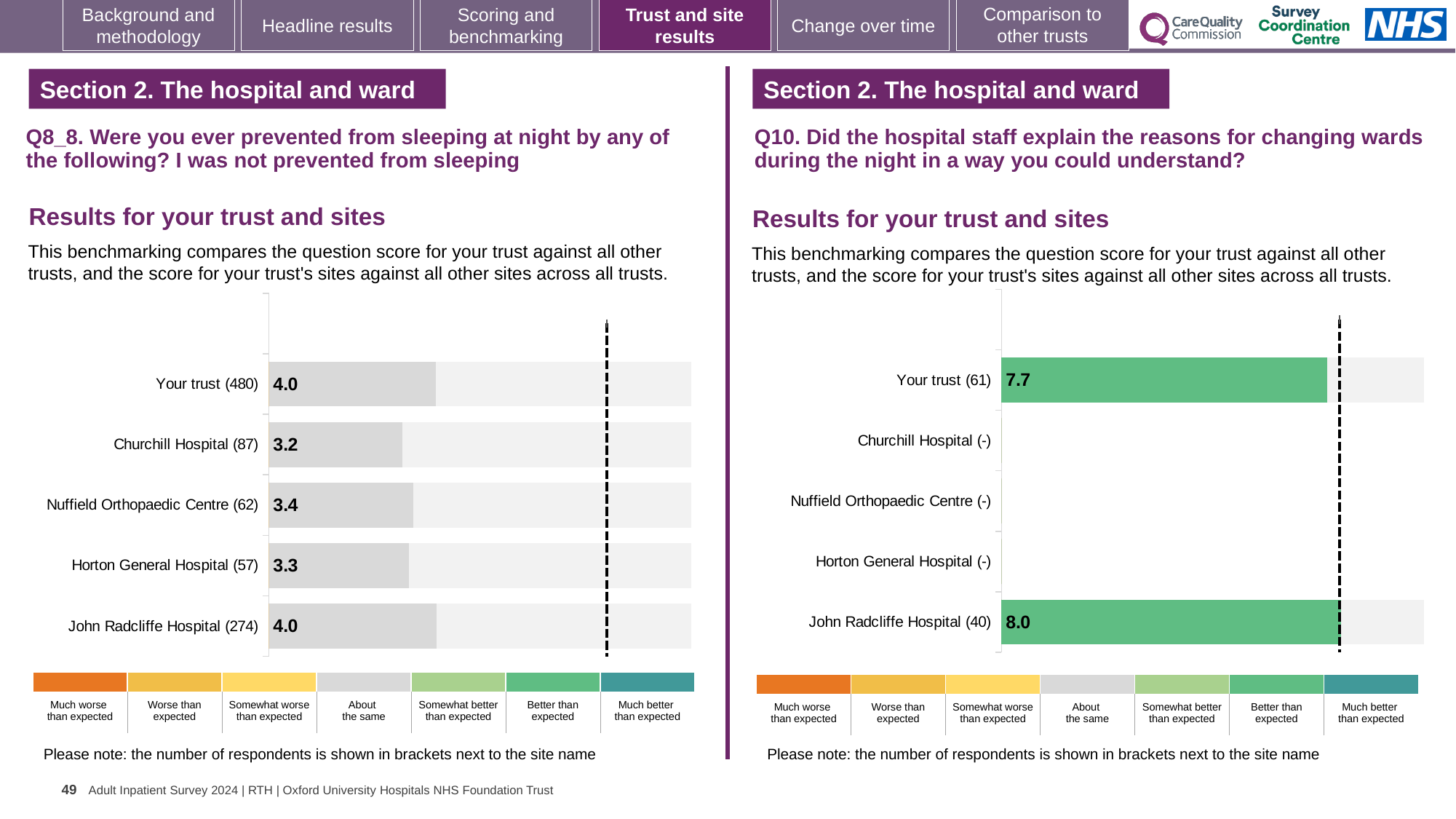
In the Q8_8 chart on the left, what is the score for Churchill Hospital? 3.2 In the Q8_8 chart on the left, what is the difference between the score for Your trust and the score for Churchill Hospital? 0.8 In the Q8_8 chart on the left, which site has the lowest score? Churchill Hospital In the Q10 chart on the right, what is the score for John Radcliffe Hospital? 8.0 In the Q10 chart on the right, how many sites have a score plotted (excluding Your trust)? 1 In the Q8_8 chart on the left, which has the higher score, Nuffield Orthopaedic Centre or Horton General Hospital? Nuffield Orthopaedic Centre In the Q8_8 chart on the left, what is the score for Nuffield Orthopaedic Centre? 3.4 What kind of chart is used on the left for Q8_8? Bar chart In the Q8_8 chart on the left, what is the score for Horton General Hospital? 3.3 In the Q10 chart on the right, what is the score for Your trust? 7.7 In the Q10 chart on the right, what is the difference between the score for John Radcliffe Hospital and the score for Your trust? 0.3 In the Q8_8 chart on the left, how many respondents are shown for John Radcliffe Hospital? 274